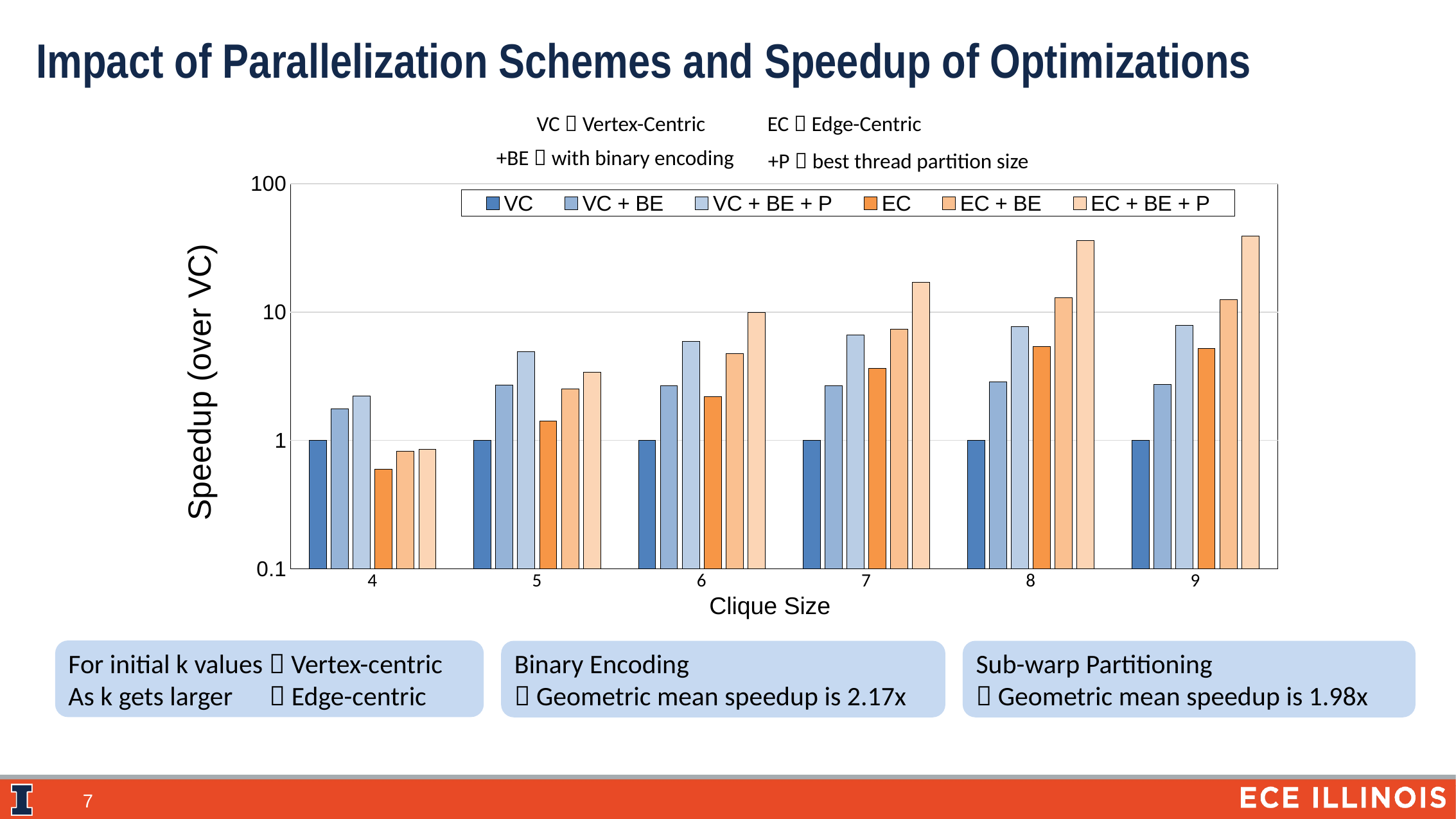
Does the speedup for EC + BE + P generally rise or fall as clique size increases from 4 to 9? rise Is the value for EC + BE + P at clique size 9 greater or less than 10? greater What is the speedup value for VC at clique size 4? 1 At clique size 5, which is larger: VC + BE + P or EC + BE + P? VC + BE + P Is the value for VC + BE + P at clique size 6 greater or less than 10? less Is the value for EC at clique size 4 greater or less than 1? less How many clique sizes are shown on the x axis? 6 What is the title of the y axis? Speedup (over VC) Which series has the highest speedup at clique size 7? EC + BE + P What kind of chart is shown on the slide? bar chart How many series does the legend list? 6 Which series has the lowest speedup at clique size 4? EC